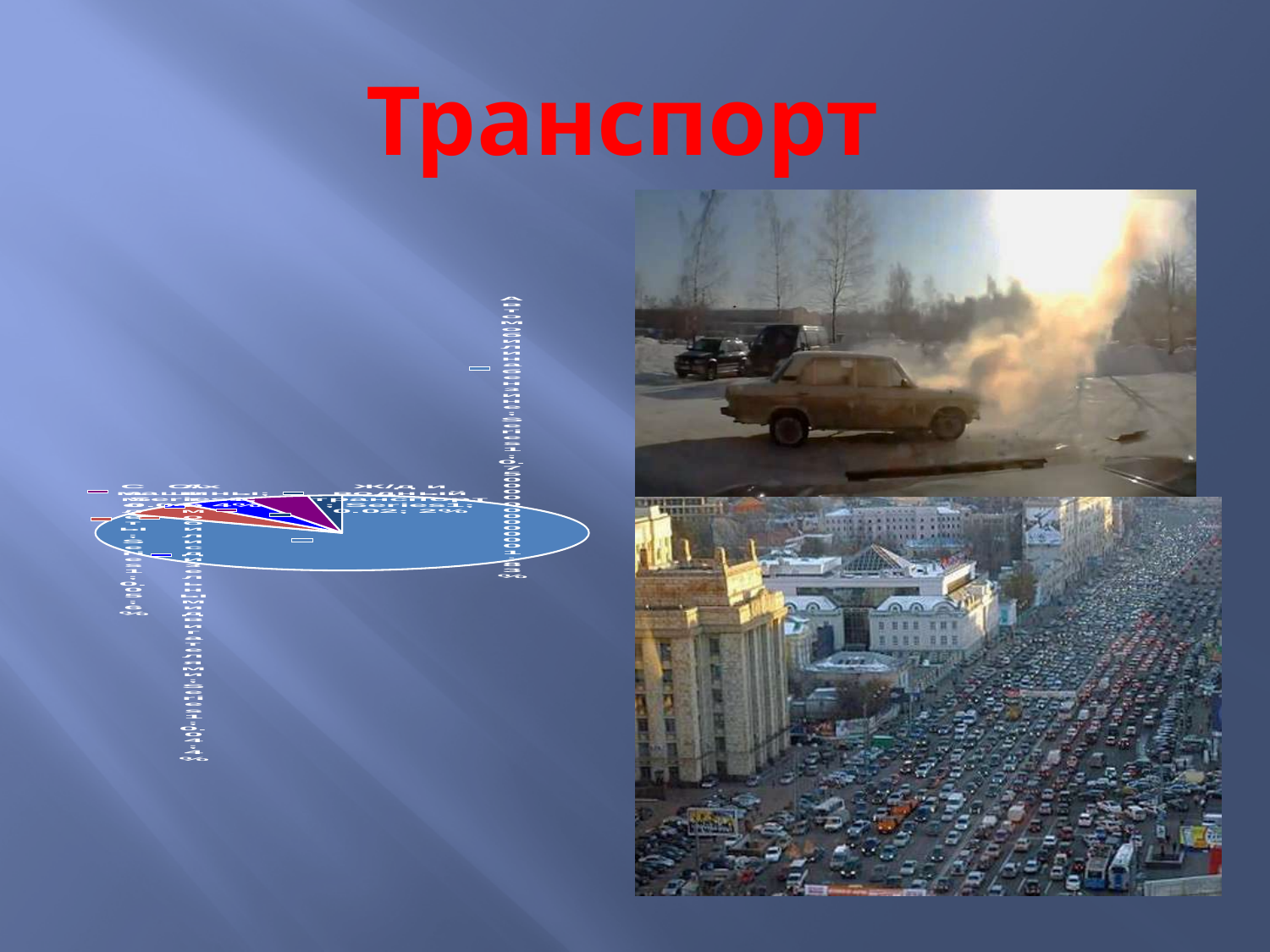
What kind of chart is shown on the left of the slide? pie chart What colour is the largest slice of the pie chart? light blue What share of the pie does the slice labelled "Ж/д и водный транспорт" represent? 2% What is the title of the slide containing the pie chart? Транспорт